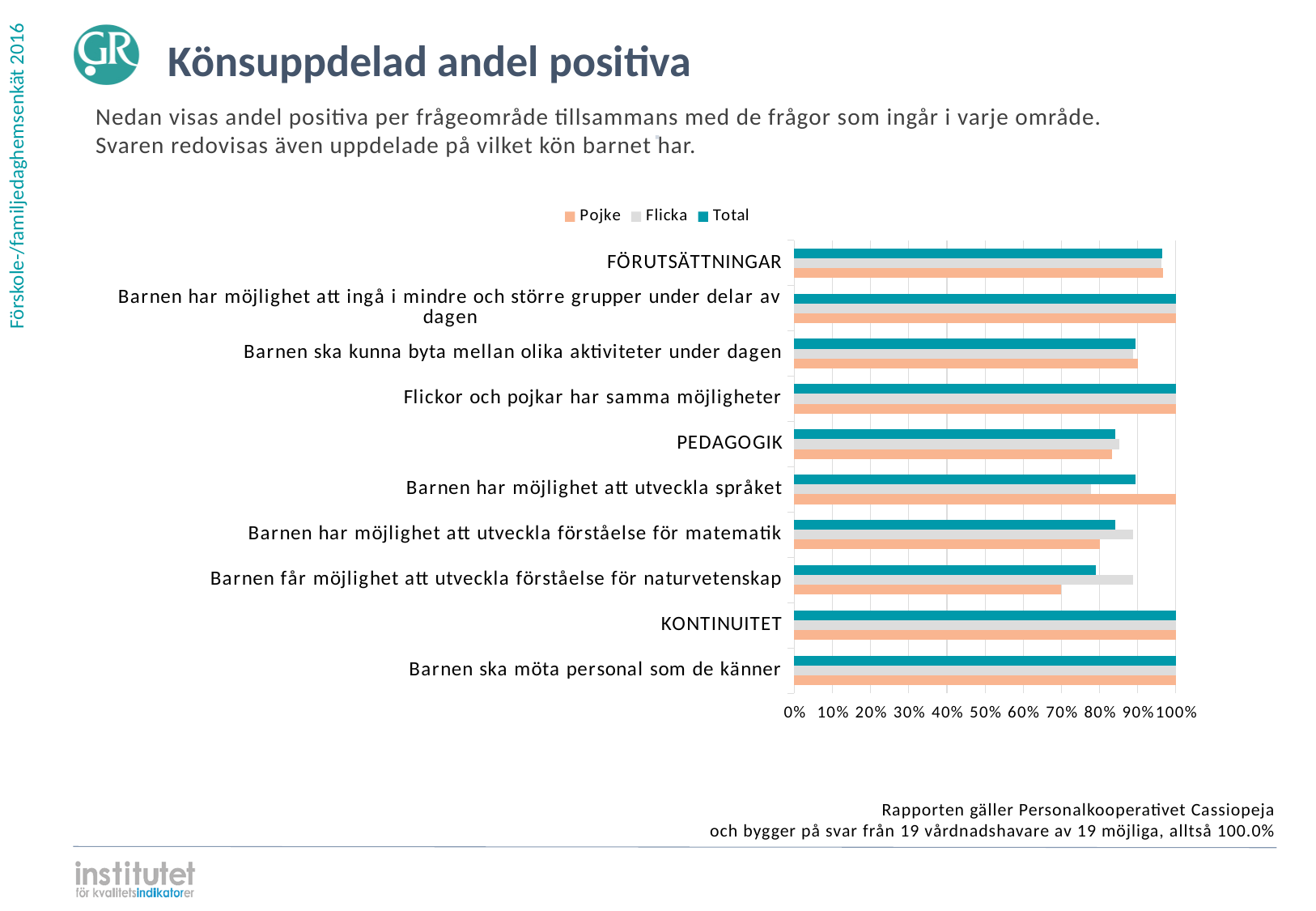
How many series does the legend list? 3 For 'Barnen får möjlighet att utveckla förståelse för naturvetenskap', which is larger, the Pojke value or the Flicka value? Flicka What is the Total value for KONTINUITET? 100% Is the Flicka value for 'Barnen har möjlighet att utveckla språket' greater or less than 80%? less Is the Total value for FÖRUTSÄTTNINGAR greater or less than 90%? greater Is the Total value for PEDAGOGIK greater or less than 80%? greater What is the Pojke value for 'Barnen har möjlighet att utveckla språket'? 100% How many categories are plotted on the y axis of the chart? 10 What is the Flicka value for 'Flickor och pojkar har samma möjligheter'? 100% Which category has the lowest Pojke value? Barnen får möjlighet att utveckla förståelse för naturvetenskap Which series is shown in orange in the legend? Pojke What kind of chart is shown on the slide? bar chart